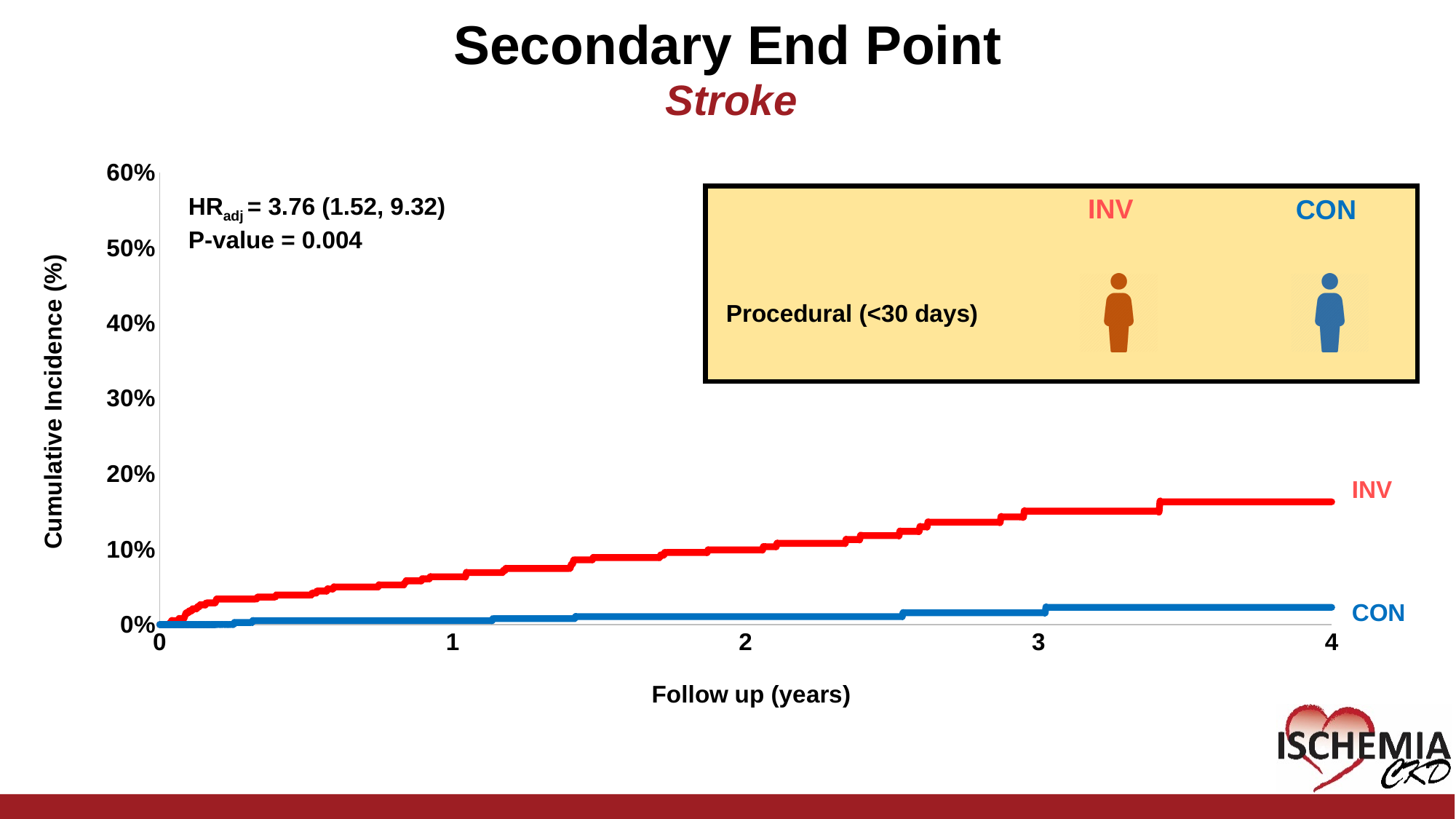
Is the cumulative incidence for INV at 2 years greater or less than 20%? less Is the cumulative incidence for CON at 4 years greater or less than 10%? less Which series has the lower cumulative incidence across the follow up period? CON What is the P-value printed on the chart? 0.004 How many series are plotted on the chart? 2 Is the cumulative incidence for INV at 4 years greater or less than 10%? greater What kind of chart is shown on the slide? line chart Which series has the higher cumulative incidence at 4 years of follow up, INV or CON? INV Does the cumulative incidence for INV rise or fall as follow up time increases? rise What is the adjusted hazard ratio printed on the chart? 3.76 (1.52, 9.32)